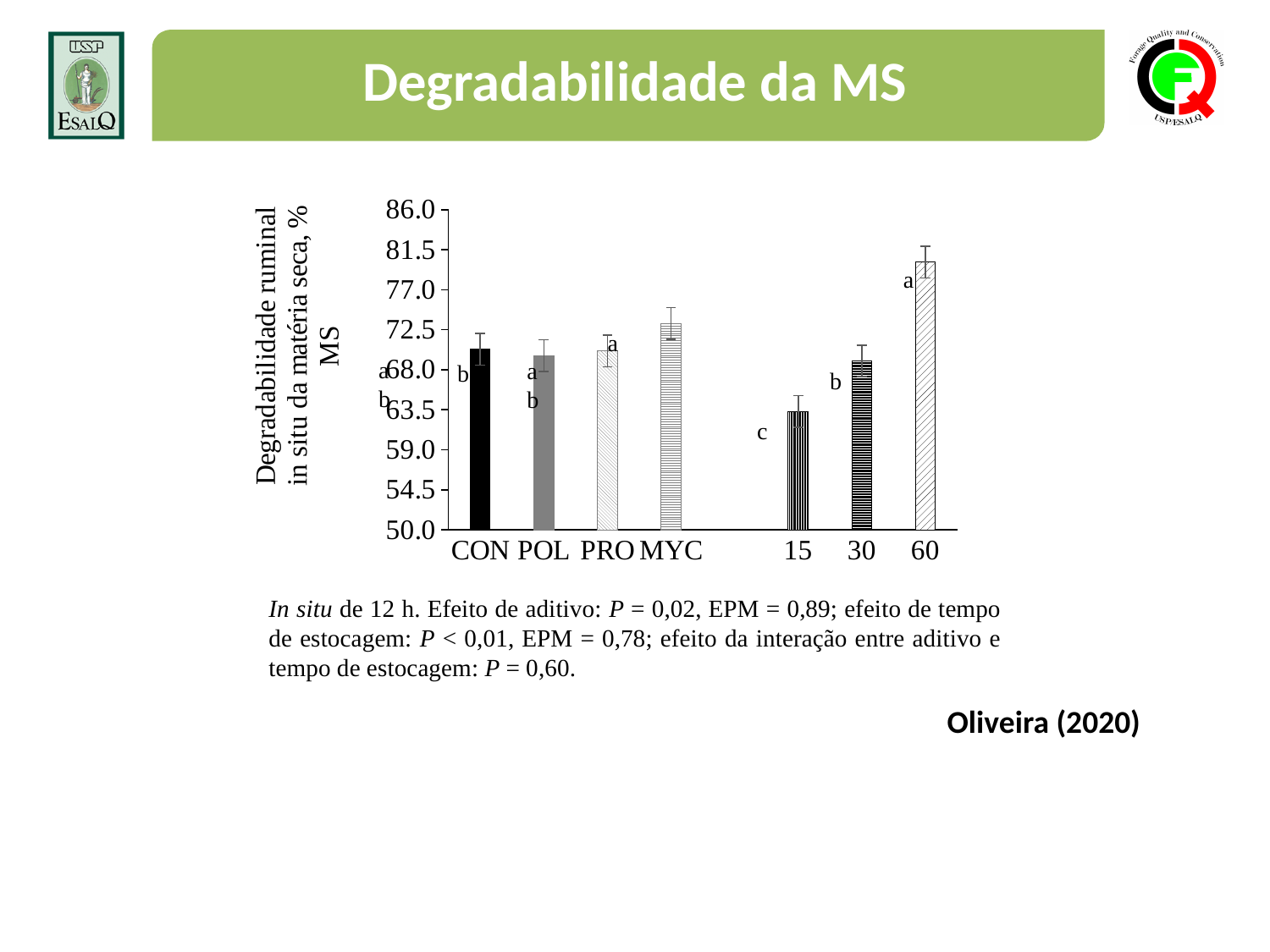
Is the value for MYC greater or less than 68.0? greater What is the title of the slide containing the chart? Degradabilidade da MS Which has the larger value, MYC or 15? MYC Which category has the highest bar in the chart? 60 Is the value for 30 greater or less than 72.5? less Is the value for 60 greater or less than 77.0? greater What kind of chart is shown on the slide? bar chart How many categories are shown on the x axis of the chart? 7 Which category has the lowest bar in the chart? 15 Which has the larger value, 60 or 15? 60